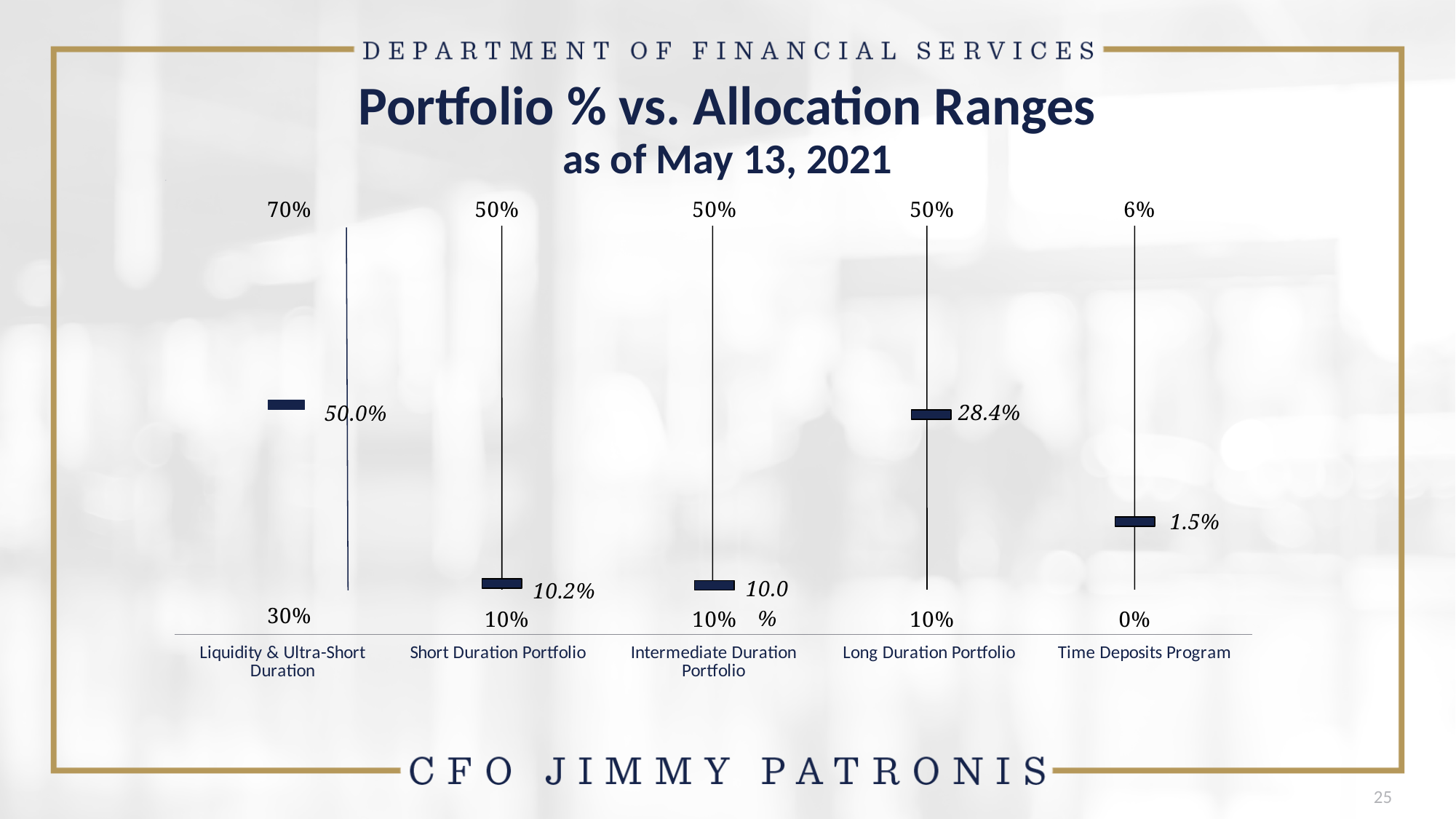
What is the portfolio % for Liquidity & Ultra-Short Duration? 50.0% How many portfolio categories are shown on the chart? 5 Which category has the highest portfolio %? Liquidity & Ultra-Short Duration What is the portfolio % for the Time Deposits Program? 1.5% Which has a larger portfolio %, the Short Duration Portfolio or the Intermediate Duration Portfolio? Short Duration Portfolio What is the difference between the portfolio % of the Long Duration Portfolio and the Short Duration Portfolio? 18.2% What is the portfolio % for the Long Duration Portfolio? 28.4% What is the upper limit of the allocation range for Liquidity & Ultra-Short Duration? 70% What is the portfolio % for the Short Duration Portfolio? 10.2% Which category has the lowest portfolio %? Time Deposits Program What is the lower limit of the allocation range for the Time Deposits Program? 0% What date is the chart's data as of, according to the title? May 13, 2021